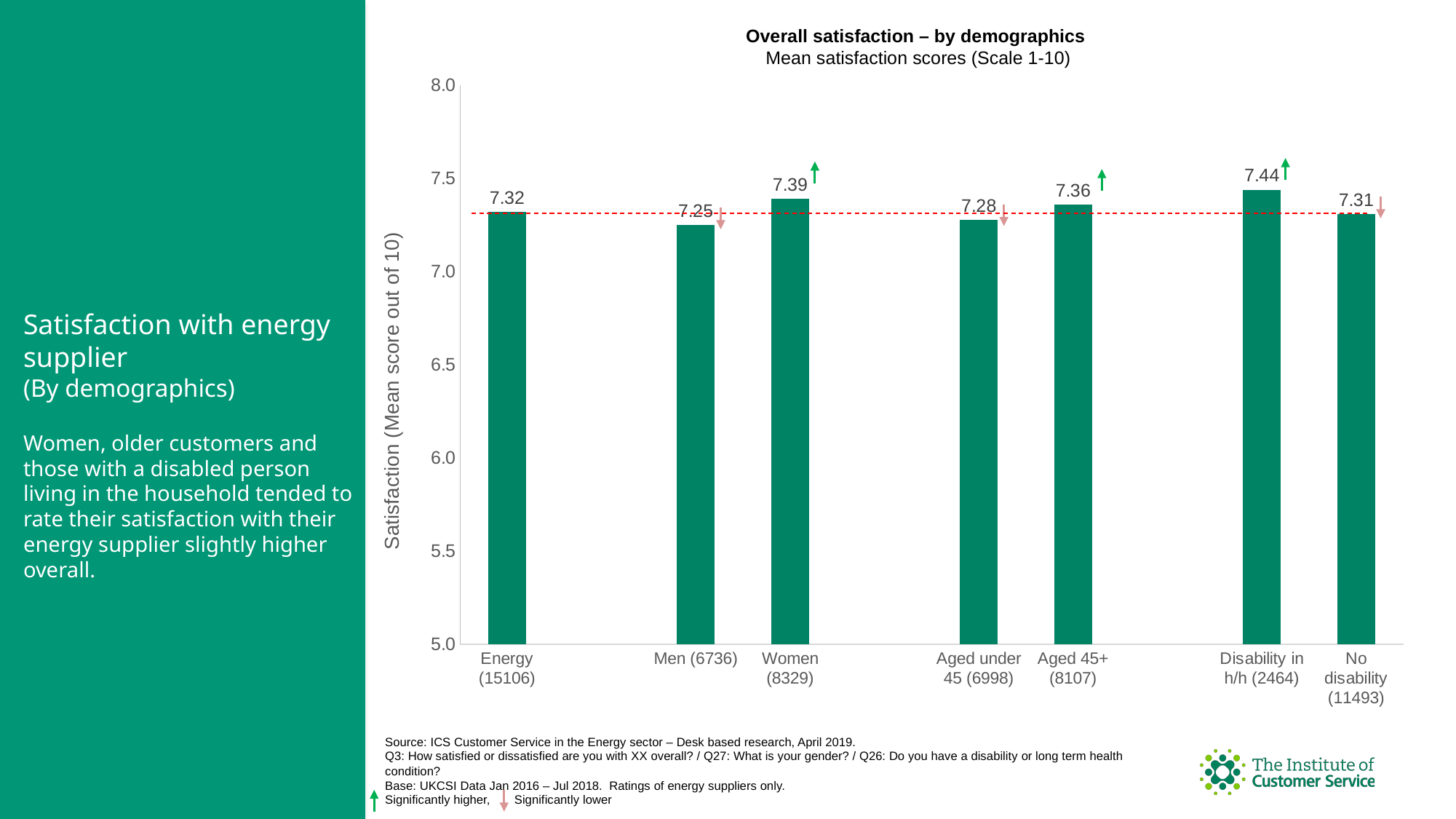
Which category has the lowest mean satisfaction score? Men (6736) How many categories are shown on the chart? 7 Which has a higher mean satisfaction score, Aged 45+ (8107) or Aged under 45 (6998)? Aged 45+ (8107) Is the value for No disability (11493) greater or less than 7.5? less What is the mean satisfaction score for Men (6736)? 7.25 What kind of chart is shown on the slide? Bar chart What is the mean satisfaction score for Energy (15106) overall? 7.32 What is the mean satisfaction score for Women (8329)? 7.39 What is the title of the chart? Overall satisfaction – by demographics What is the mean satisfaction score for Disability in h/h (2464)? 7.44 What is the difference between the scores for Women (8329) and Men (6736)? 0.14 Which category has the highest mean satisfaction score? Disability in h/h (2464)